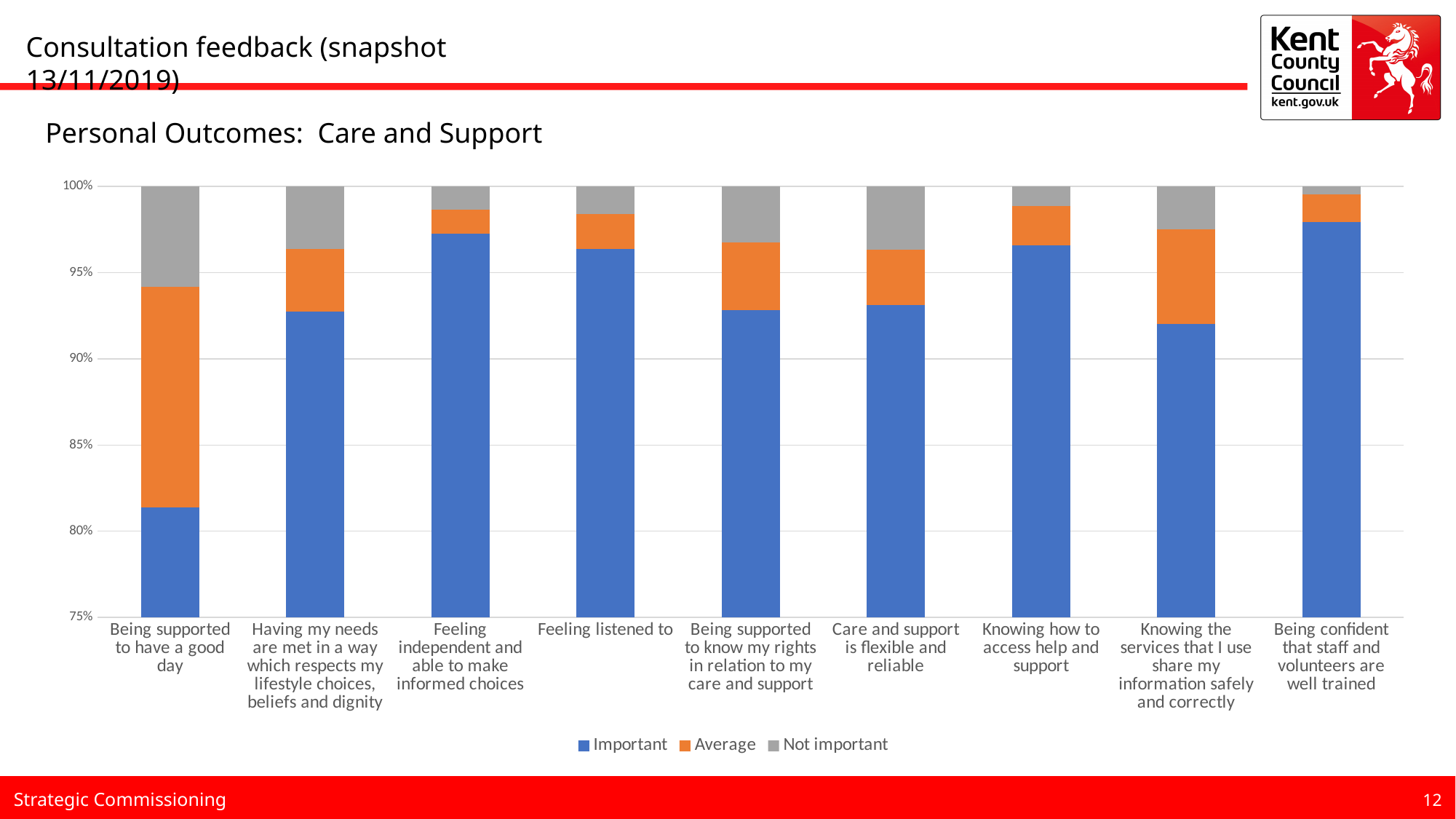
Is the 'Important' value for 'Being supported to have a good day' greater or less than 85%? less What does each stacked bar total, as shown by the top of the y axis? 100% What is the title shown above the chart? Personal Outcomes: Care and Support Which category has the smallest 'Important' segment? Being supported to have a good day How many categories (personal outcomes) are shown along the x axis? 9 What kind of chart is shown on the slide? Stacked bar chart How many series does the legend list? 3 Which category has the largest 'Average' segment? Being supported to have a good day Is the 'Important' value for 'Feeling listened to' greater or less than 95%? greater Is the 'Important' value for 'Having my needs are met in a way which respects my lifestyle choices, beliefs and dignity' greater or less than 95%? less Which series is shown in blue according to the legend? Important Which has the larger 'Important' value: 'Feeling listened to' or 'Care and support is flexible and reliable'? Feeling listened to